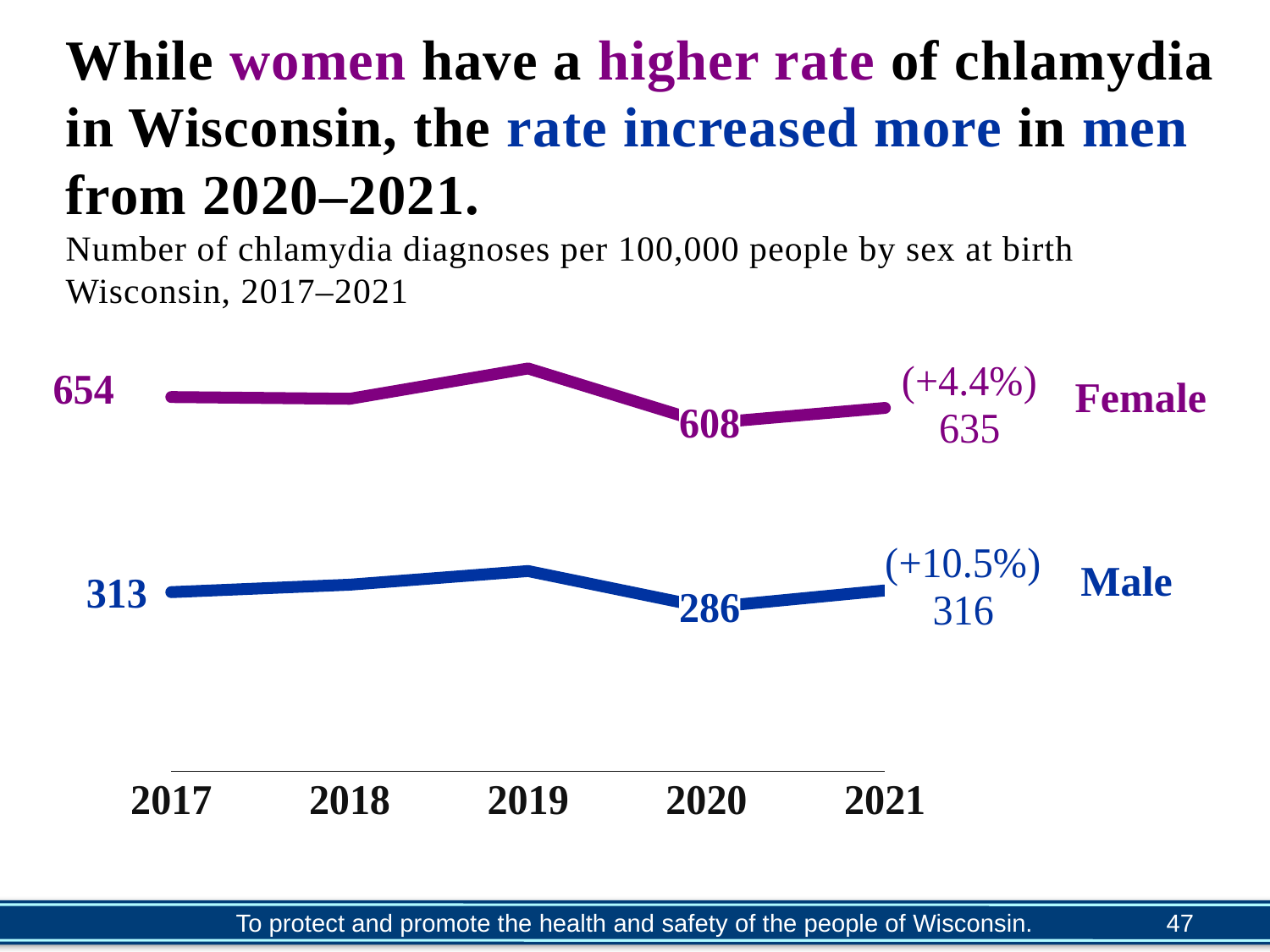
By what percentage did the female rate change from 2020 to 2021, as labeled on the chart? +4.4% What was the female chlamydia rate per 100,000 in Wisconsin in 2017? 654 What was the female chlamydia rate per 100,000 in 2021? 635 How many years are shown on the x axis? 5 What was the male chlamydia rate per 100,000 in 2021? 316 By what percentage did the male rate change from 2020 to 2021, as labeled on the chart? +10.5% What type of chart is shown on the slide? Line chart How many series are plotted on the chart? 2 What is the difference between the female and male rates in 2021? 319 Which series had the higher rate in 2020, Female or Male? Female What was the male chlamydia rate per 100,000 in Wisconsin in 2020? 286 How much did the female rate decrease from 2017 to 2020? 46